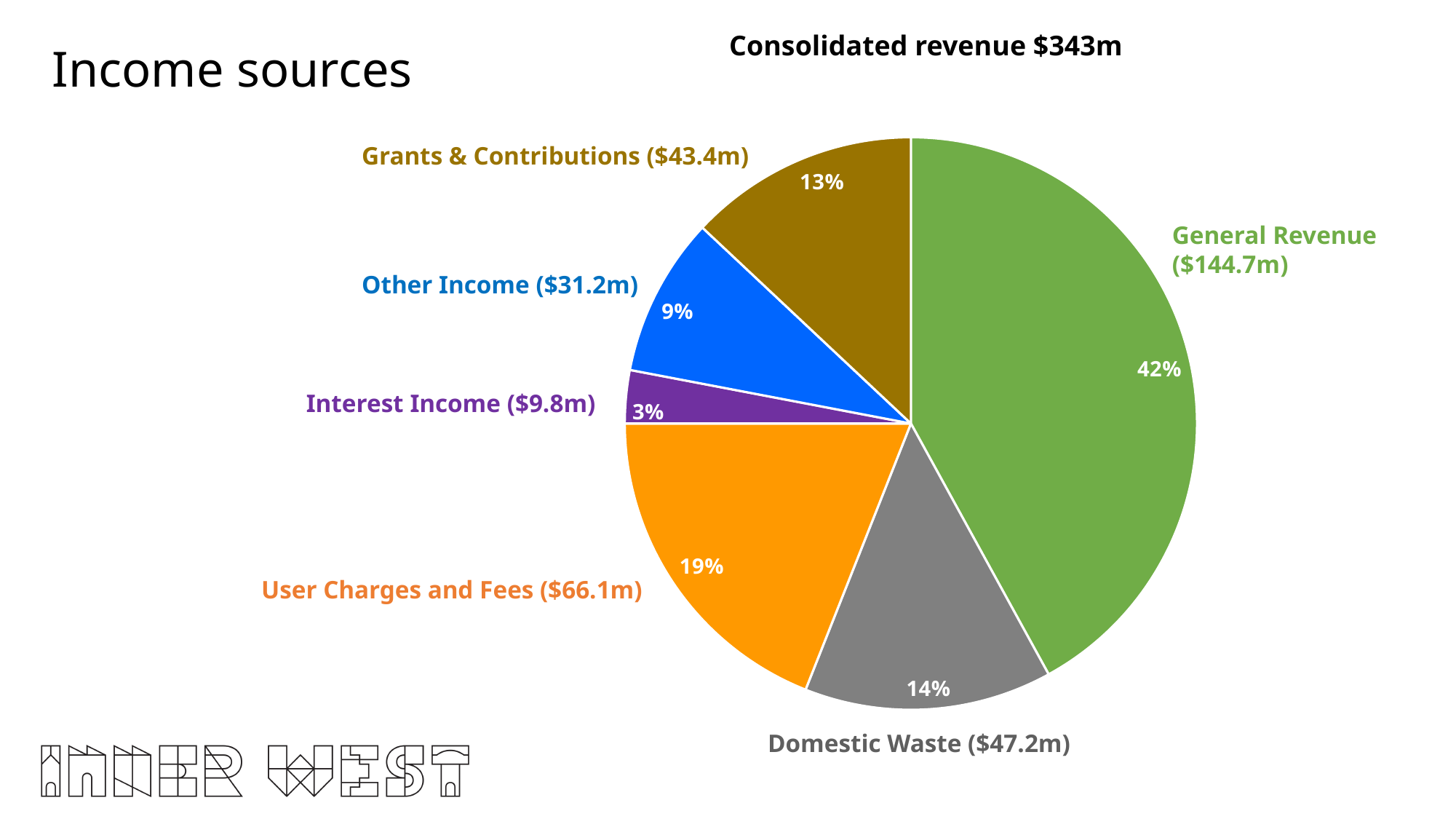
What share of the pie is General Revenue? 42% What is the value shown for Domestic Waste? $47.2m Which income source is the smallest slice of the pie? Interest Income Which is larger, Grants & Contributions or Other Income? Grants & Contributions What colour is the Other Income slice? Blue Which income source is the largest slice of the pie? General Revenue How many slices does the pie chart have? 6 What is the value shown for Interest Income? $9.8m What share of the pie is User Charges and Fees? 19% What kind of chart is shown on the slide? Pie chart What is the title of the chart? Consolidated revenue $343m What is the difference in percentage points between the General Revenue share and the User Charges and Fees share? 23